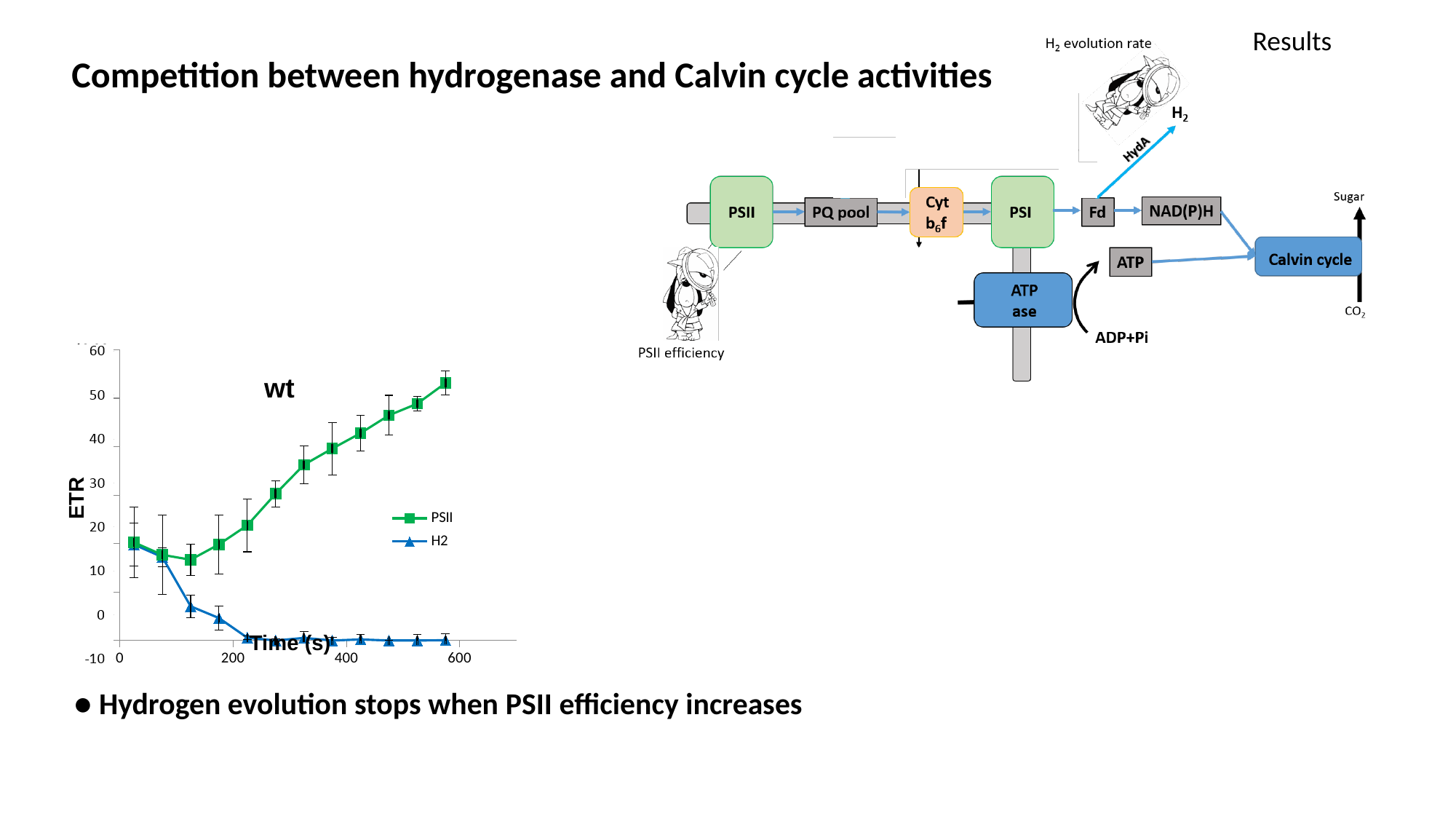
Is the value of the PSII series at its first point (near 0 s) greater or less than 10? greater Does the PSII series rise or fall between 200 s and 600 s? rise At the last time point (near 600 s), which series has the larger value, PSII or H2? PSII What are the two series named in the chart legend? PSII and H2 What is the label on the y axis of the chart? ETR Is the value of the PSII series at its last point (near 600 s) greater or less than 40? greater Does the H2 series rise or fall as time increases along the x axis? fall What kind of chart is shown on the slide? line chart How many series does the chart legend list? 2 Which series reaches the highest ETR value on the chart? PSII How many data points are plotted for the PSII series? 12